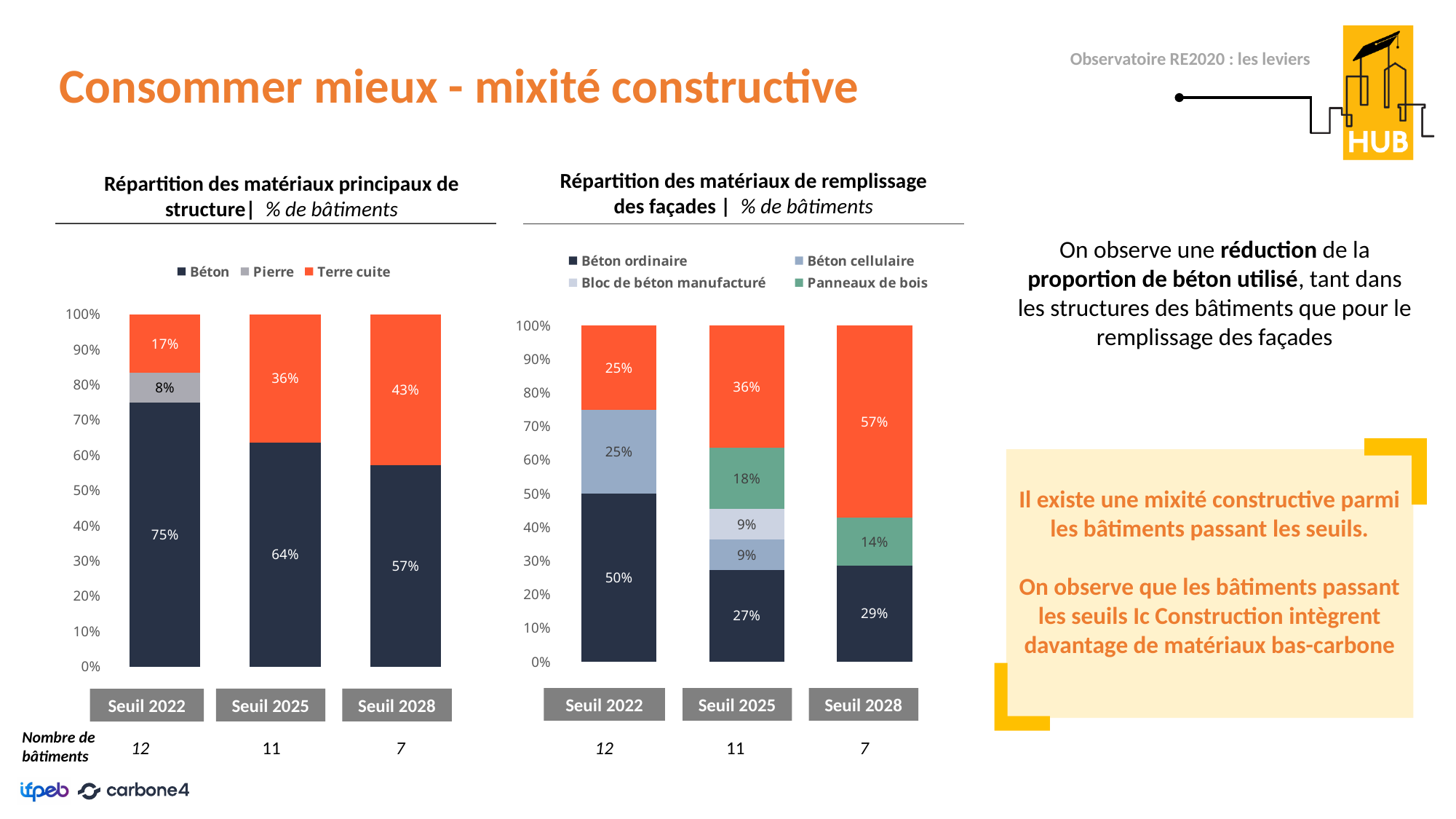
In the left chart (Répartition des matériaux principaux de structure), does the Béton share rise or fall from Seuil 2022 to Seuil 2028? fall In the right chart (Répartition des matériaux de remplissage des façades), what is the value for Panneaux de bois at Seuil 2028? 14% In the left chart (Répartition des matériaux principaux de structure), what is the value for Pierre at Seuil 2022? 8% In the right chart (Répartition des matériaux de remplissage des façades), how many bars (seuil categories) are shown? 3 In the right chart (Répartition des matériaux de remplissage des façades), which is larger: Béton ordinaire at Seuil 2022 or Béton ordinaire at Seuil 2028? Seuil 2022 In the right chart (Répartition des matériaux de remplissage des façades), what is the value for Béton ordinaire at Seuil 2025? 27% What kind of chart is the left chart (Répartition des matériaux principaux de structure)? stacked bar chart In the left chart (Répartition des matériaux principaux de structure), what is the value for Terre cuite at Seuil 2028? 43% In the left chart (Répartition des matériaux principaux de structure), how many series does the legend list? 3 In the right chart (Répartition des matériaux de remplissage des façades), what is the value for Béton cellulaire at Seuil 2022? 25% In the left chart (Répartition des matériaux principaux de structure), what is the value for Béton at Seuil 2022? 75% In the left chart (Répartition des matériaux principaux de structure), what is the difference between the Béton values for Seuil 2022 and Seuil 2028? 18%